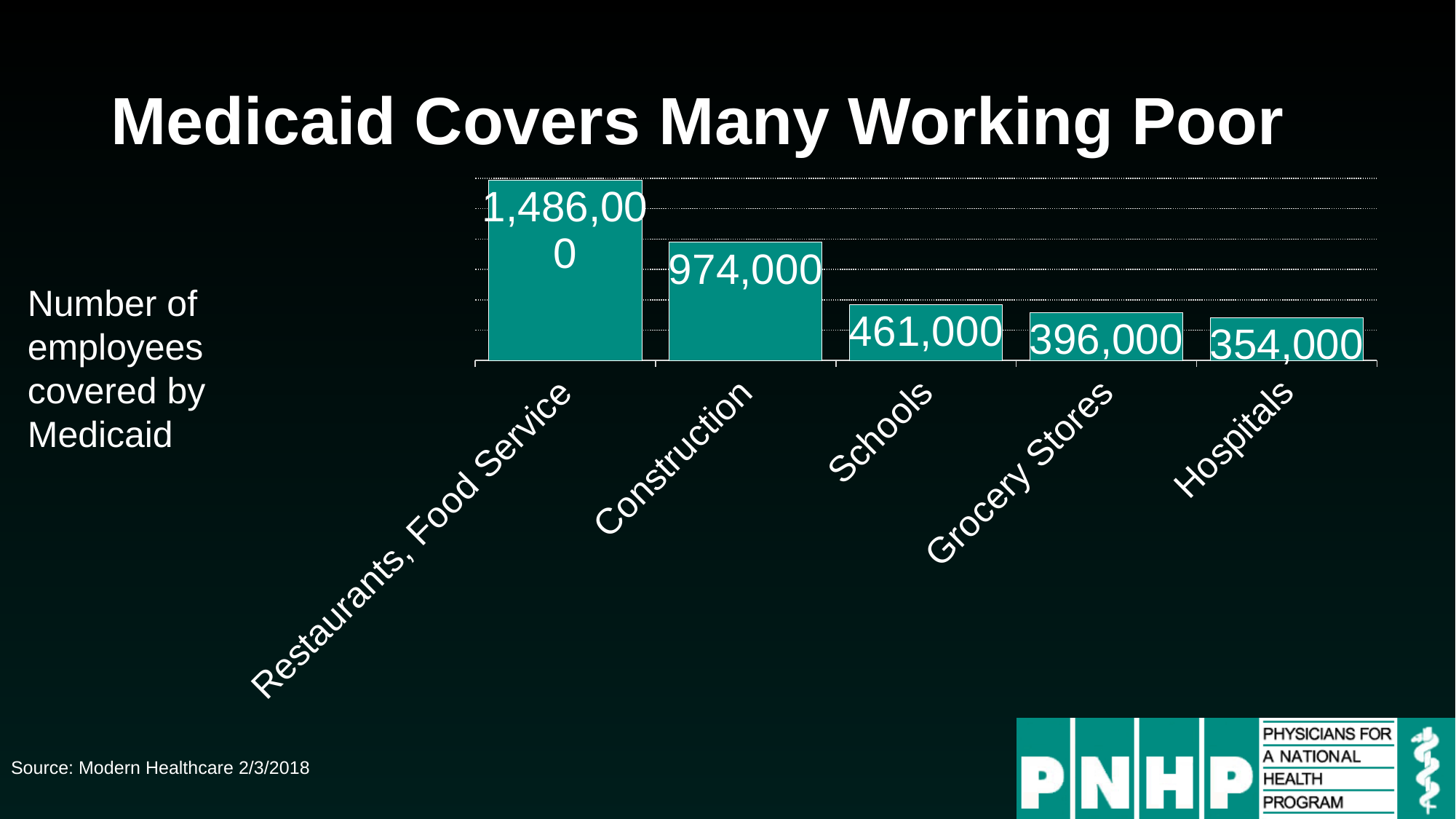
Which category has the lowest number of employees covered by Medicaid? Hospitals What kind of chart is shown on the slide? Bar chart How many employees covered by Medicaid work in Construction? 974,000 What is the difference between the values for Schools and Hospitals? 107,000 Which category has the highest number of employees covered by Medicaid? Restaurants, Food Service Which is larger, the value for Grocery Stores or the value for Hospitals? Grocery Stores How many categories are shown in the chart? 5 What is the value shown for Restaurants, Food Service? 1,486,000 What is the difference between the values for Restaurants, Food Service and Construction? 512,000 What is the value shown for Grocery Stores? 396,000 What is the number of employees covered by Medicaid in Schools? 461,000 What is the value shown for Hospitals? 354,000